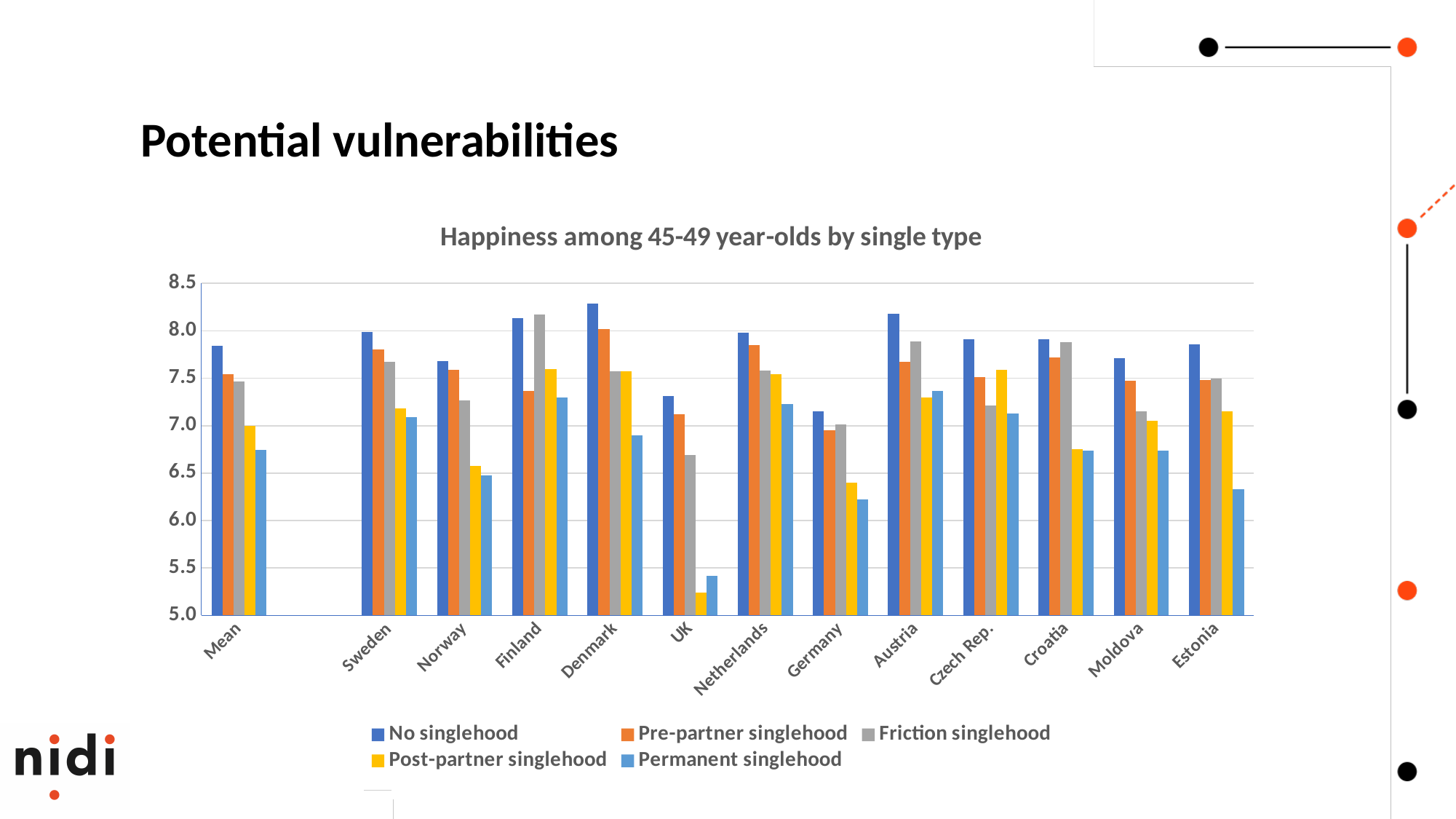
What kind of chart is shown on the slide? bar chart What is the title of the chart? Happiness among 45-49 year-olds by single type Which category has the highest value for No singlehood? Denmark Is the value for Post-partner singlehood in the UK greater or less than 5.5? less Is the value for Permanent singlehood in Germany greater or less than 6.5? less Which series is shown in yellow in the legend? Post-partner singlehood Which country has the lowest value for Post-partner singlehood? UK How many series does the legend list? 5 How many categories are shown along the x axis? 13 Which is larger: the No singlehood value for Germany or for the Netherlands? Netherlands Which is larger: the Permanent singlehood value for the UK or for Germany? Germany Is the value for No singlehood in Denmark greater or less than 8.0? greater